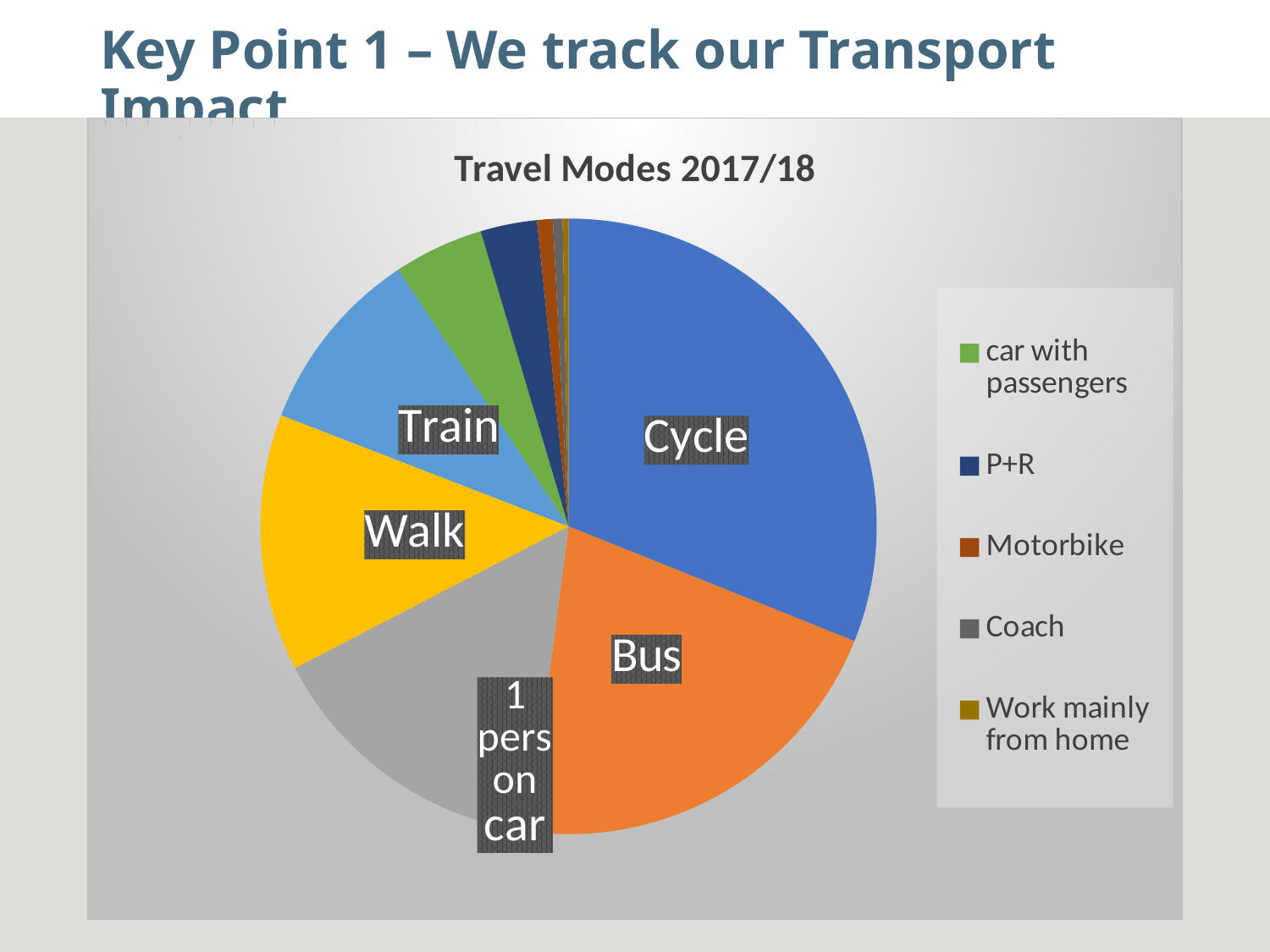
What colour is the Walk slice? yellow Which slice is larger, Walk or Train? Walk Which slice is larger, Bus or 1 person car? Bus What is the title of the chart? Travel Modes 2017/18 Which slice is larger, Cycle or Bus? Cycle How many entries does the legend list? 5 What kind of chart is shown on the slide? pie chart Which travel mode has the largest slice of the pie? Cycle How many slices have their labels printed directly on the pie? 5